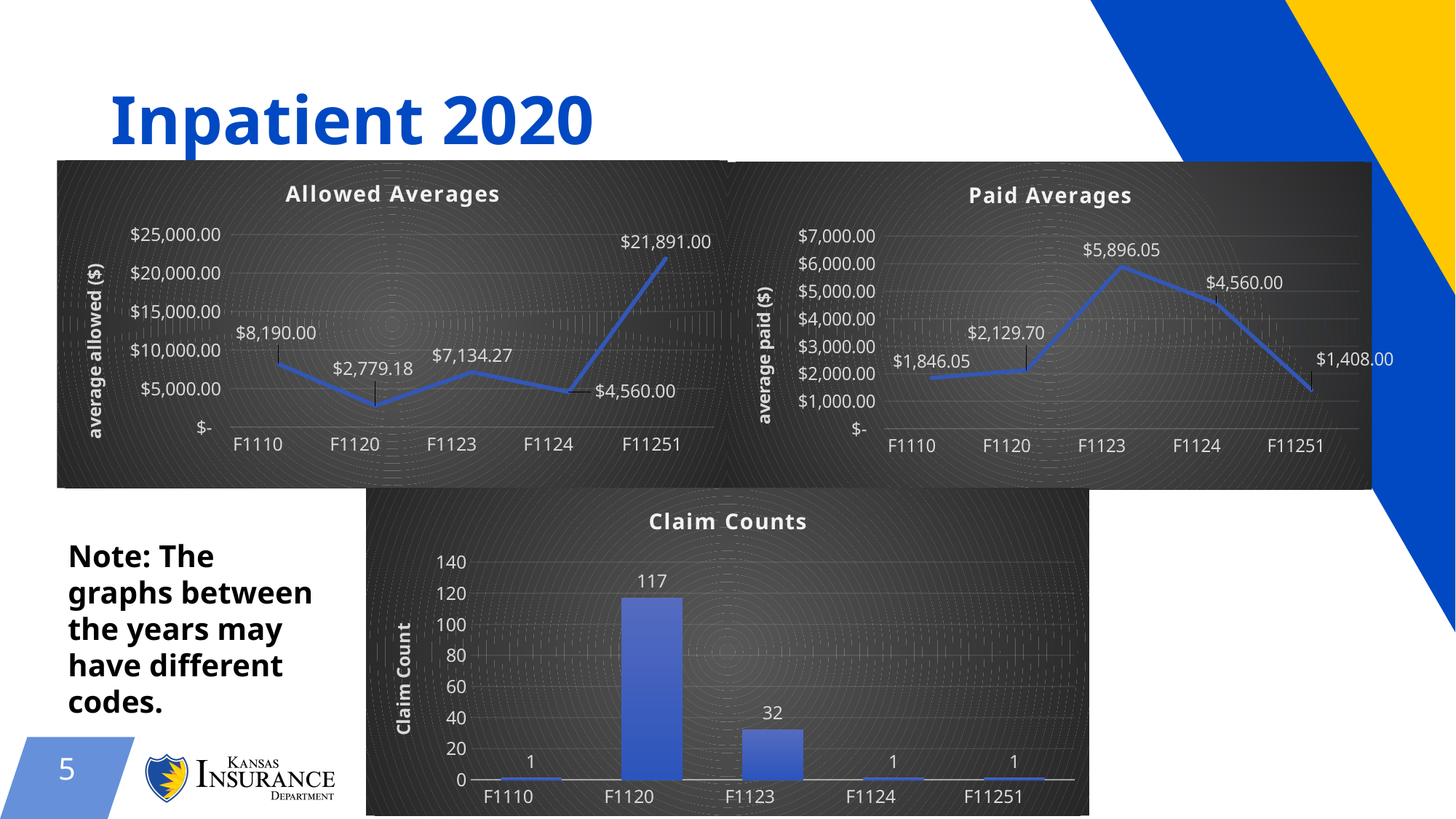
What kind of chart is the Claim Counts chart? bar chart In the Paid Averages chart, what is the difference between the values for F1123 and F1124? $1,336.05 In the Paid Averages chart, which is larger, the value for F1110 or the value for F11251? F1110 How many codes are shown on the x axis of the Claim Counts chart? 5 In the Allowed Averages chart, what is the average allowed for F11251? $21,891.00 In the Paid Averages chart, what is the average paid for F1120? $2,129.70 In the Allowed Averages chart, what is the difference between the values for F1110 and F1124? $3,630.00 What is the y-axis label of the Paid Averages chart? average paid ($) In the Claim Counts chart, what is the claim count for F1123? 32 In the Claim Counts chart, what is the difference between the claim counts for F1120 and F1123? 85 In the Allowed Averages chart, which code has the lowest average allowed? F1120 In the Paid Averages chart, which code has the highest average paid? F1123